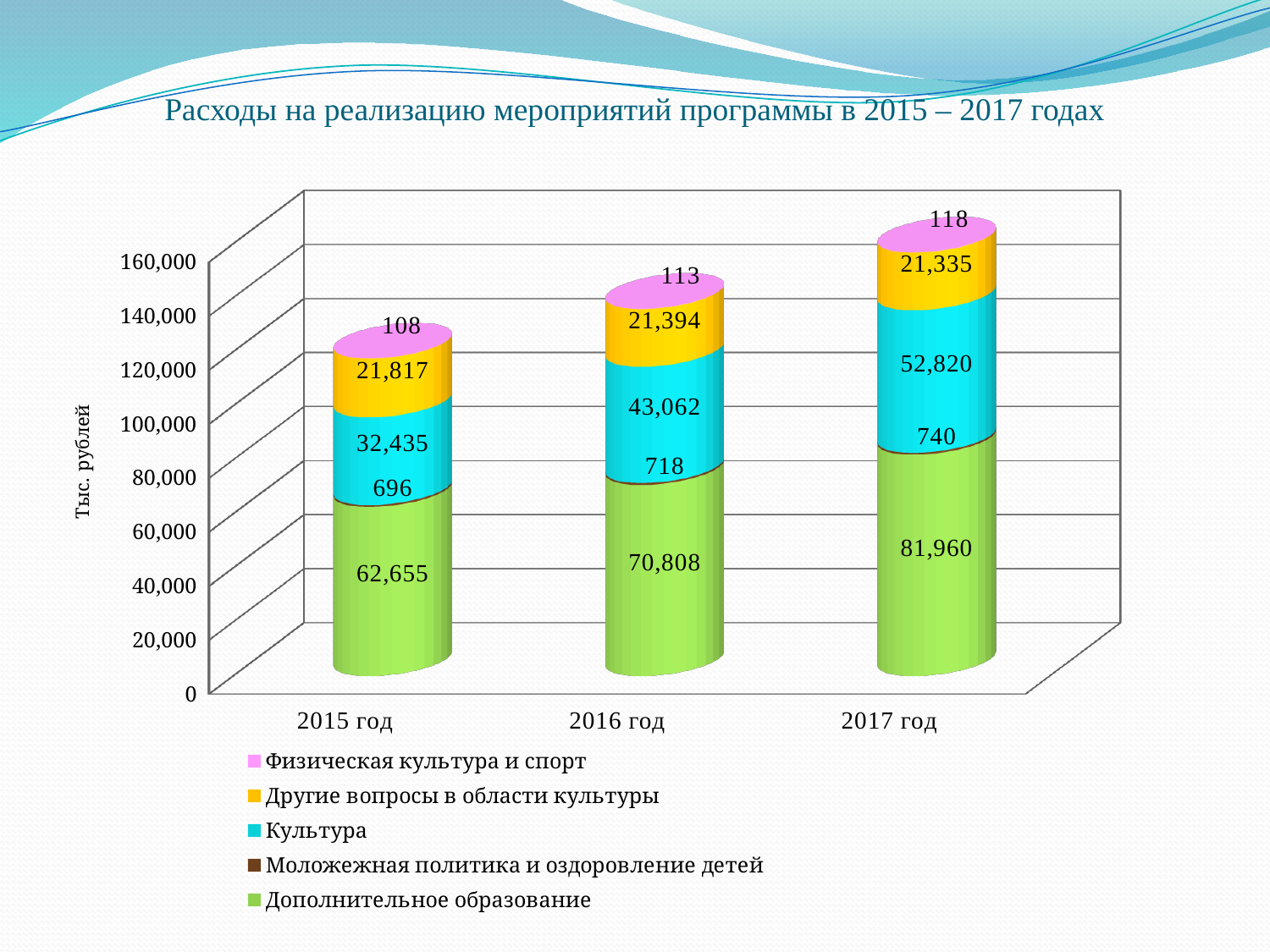
What is the value for Другие вопросы в области культуры in 2016 год? 21,394 What is the difference between the Культура values for 2017 год and 2015 год? 20,385 In which year is the value for Дополнительное образование highest? 2017 год Which is larger: Другие вопросы в области культуры in 2015 год or in 2017 год? 2015 год What is the value for Культура in 2017 год? 52,820 What is the value for Физическая культура и спорт in 2017 год? 118 What kind of chart is shown on the slide? Stacked bar chart In which year is the value for Культура lowest? 2015 год What is the value for Дополнительное образование in 2015 год? 62,655 What is the value for Моложежная политика и оздоровление детей in 2016 год? 718 What is the total of the stacked bar for 2016 год? 136,095 How many series does the legend list? 5